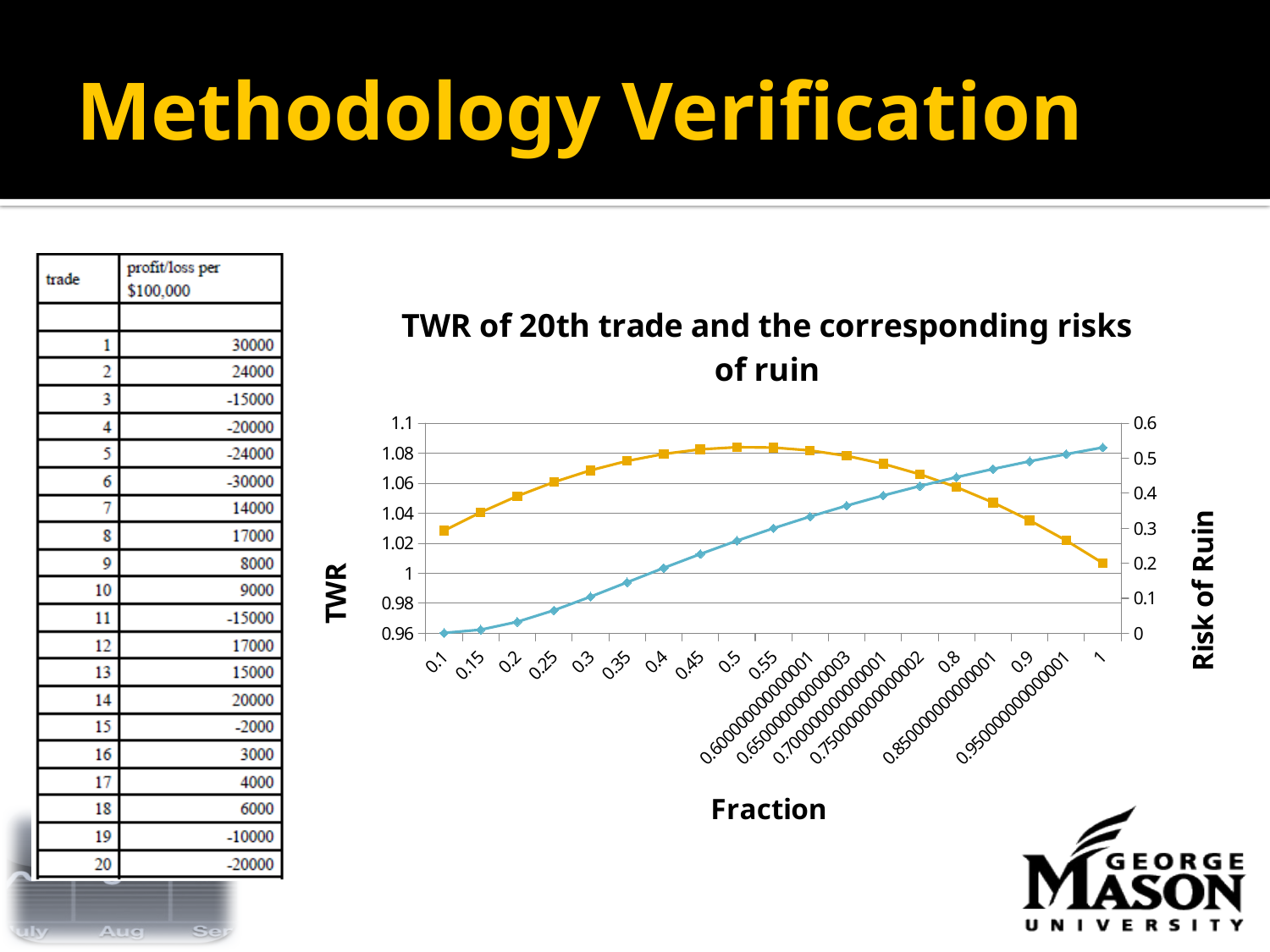
What is the label of the x axis of the chart? Fraction What is the title of the chart? TWR of 20th trade and the corresponding risks of ruin Is the TWR value (orange line) at fraction 0.1 greater or less than 1? greater At which fraction is the blue Risk of Ruin line at its highest? 1 At which fraction is the orange TWR line at its lowest? 1 How many fraction values are plotted along the x axis of the chart? 19 Is the Risk of Ruin value (blue line) at fraction 0.1 greater or less than 0.1? less Is the TWR value (orange line) at fraction 0.5 greater or less than 1.06? greater Does the blue Risk of Ruin line rise or fall as the fraction increases along the x axis? rise At which fraction is the blue Risk of Ruin line at its lowest? 0.1 What kind of chart is shown on the slide? line chart